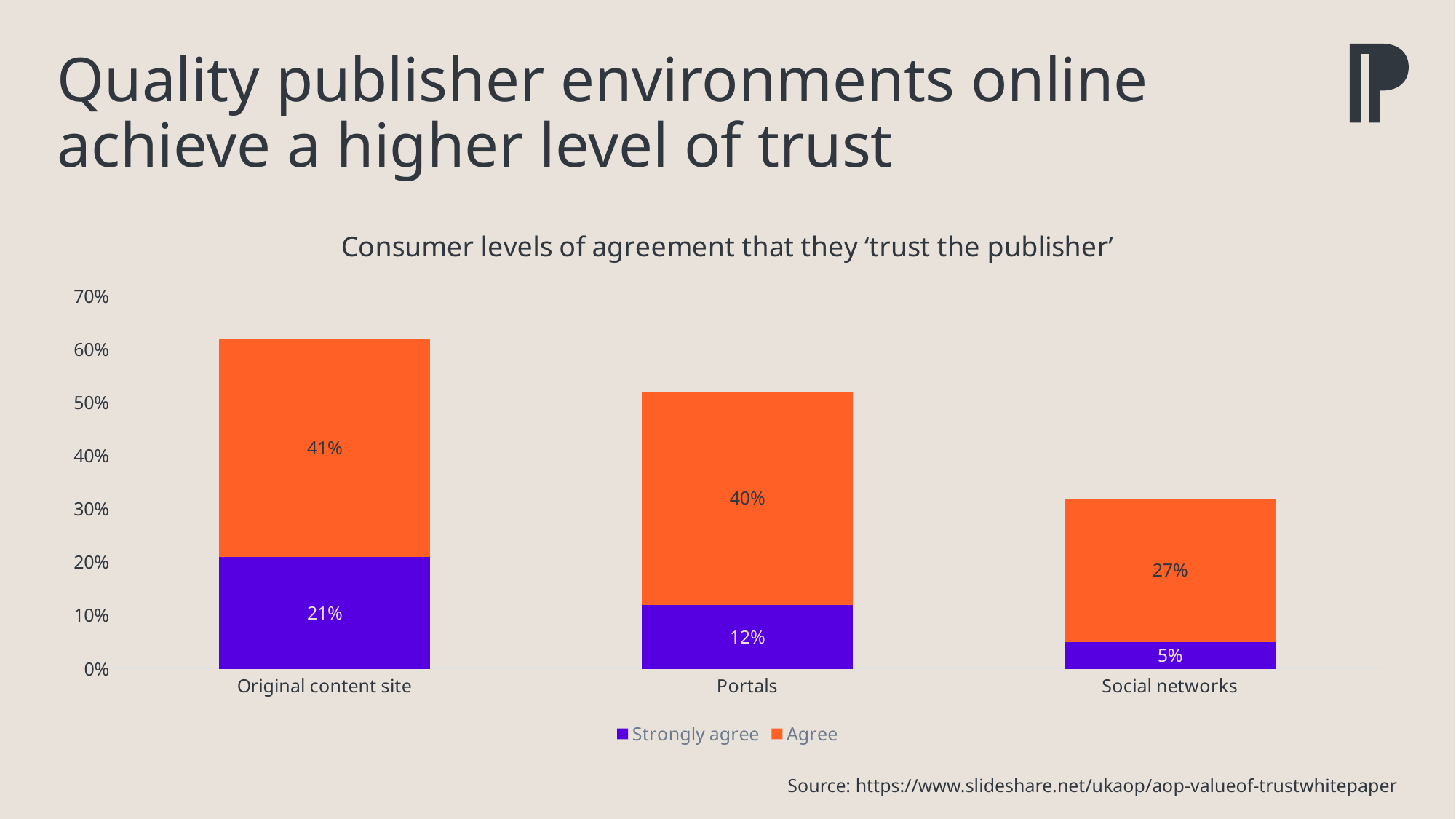
What is the 'Agree' value for Portals? 40% Which category has the lowest 'Agree' value? Social networks What is the 'Strongly agree' value for Social networks? 5% Which category has the highest 'Strongly agree' value? Original content site How many series does the legend list? 2 What is the 'Strongly agree' value for Original content site? 21% How many categories are shown on the x axis? 3 Which is larger: the 'Agree' value for Portals or the 'Agree' value for Social networks? Portals What is the difference between the 'Strongly agree' values for Original content site and Portals? 9% What is the total of the stacked bar for Social networks? 32% What kind of chart is shown on the slide? Stacked bar chart What is the total of the stacked bar for Original content site? 62%